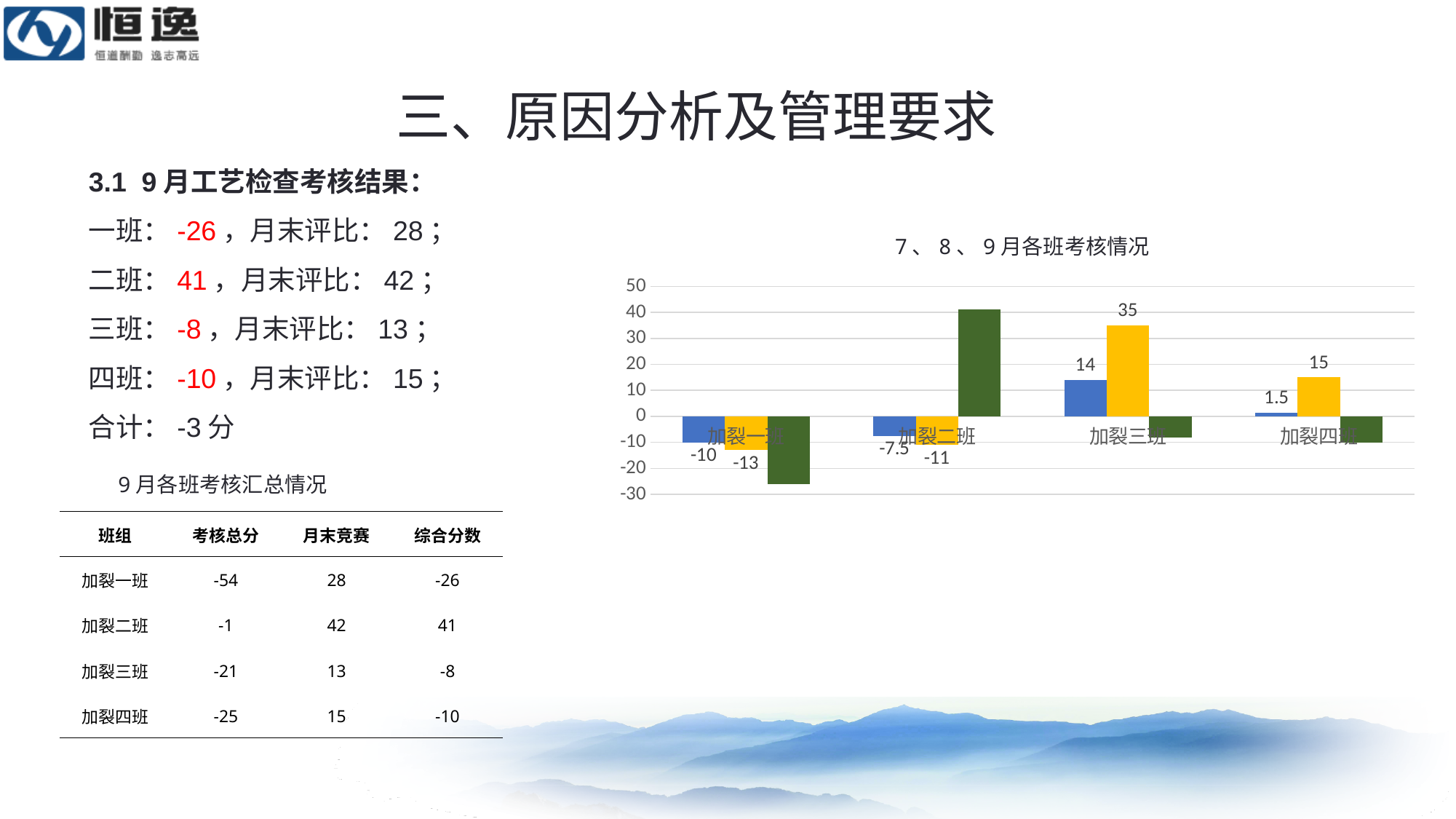
What is the difference between the yellow bar values for 加裂三班 and 加裂四班? 20 What is the value of the blue bar for 加裂二班? -7.5 What is the title of the chart? 7、8、9月各班考核情况 What is the value of the yellow bar for 加裂一班? -13 Is the blue bar for 加裂三班 larger or smaller than the blue bar for 加裂四班? larger Is the value of the green bar for 加裂二班 greater or less than 30? greater What is the value of the yellow bar for 加裂三班? 35 What is the value of the blue bar for 加裂四班? 1.5 What kind of chart is shown on the slide? bar chart Which category has the lowest blue bar? 加裂一班 Which category has the highest yellow bar? 加裂三班 How many categories (班组) are shown on the x axis of the chart? 4